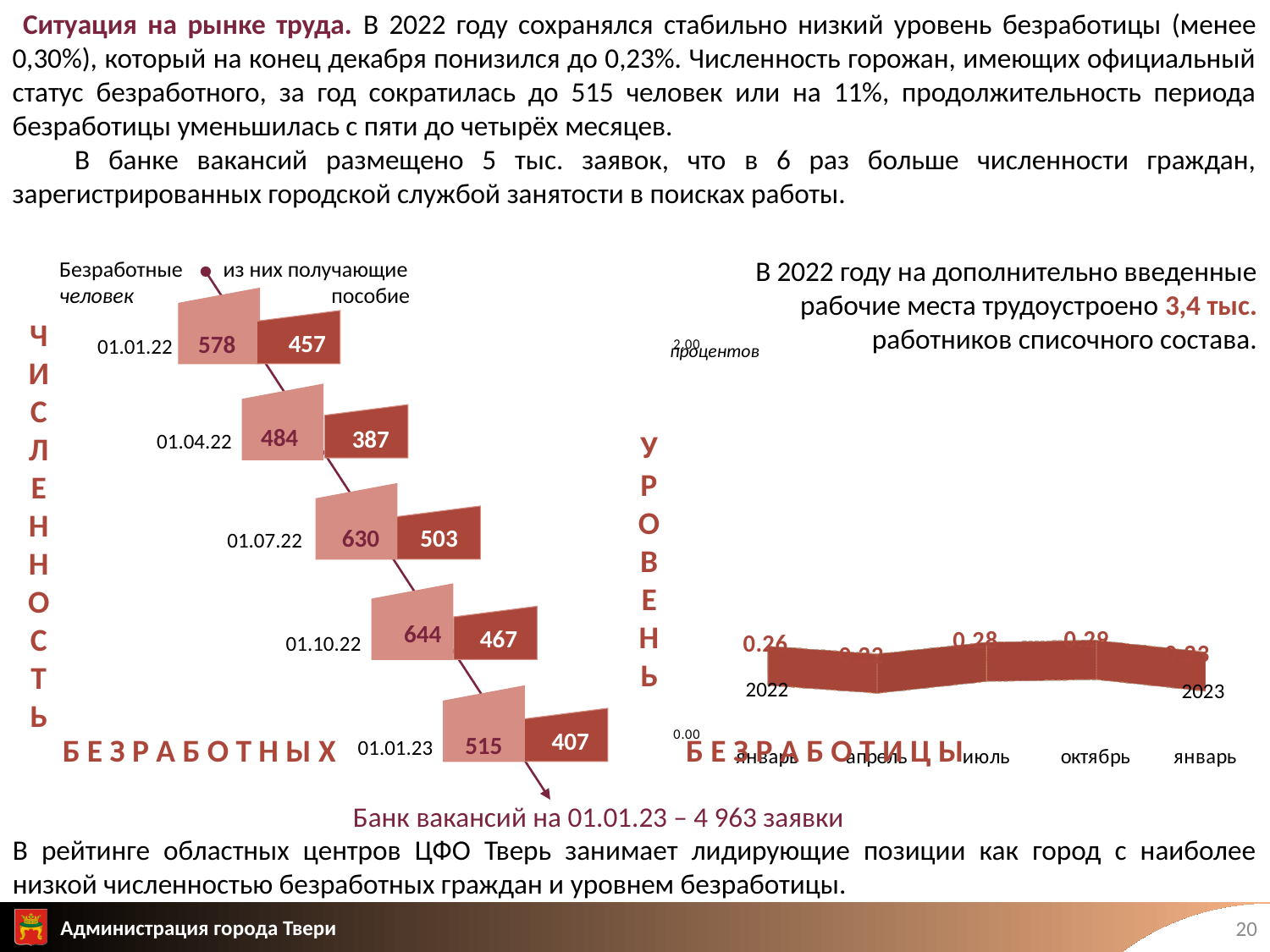
In the left chart (Численность безработных), what is the difference between Безработные and 'из них получающие пособие' on 01.01.22? 121 In the right chart (Уровень безработицы), what is the value for июль? 0.28 In the right chart (Уровень безработицы), what is the highest value shown? 0.29 In the left chart (Численность безработных), which date has more Безработные: 01.07.22 or 01.10.22? 01.10.22 In the left chart (Численность безработных), on which date is the number of Безработные lowest? 01.04.22 In the right chart (Уровень безработицы), what unit is indicated on the axis? процентов In the left chart (Численность безработных), what is the value for 'из них получающие пособие' on 01.01.23? 407 In the left chart (Численность безработных), how many dates are shown? 5 In the left chart (Численность безработных), on which date is the number of Безработные highest? 01.10.22 In the left chart (Численность безработных), what is the value for Безработные on 01.07.22? 630 In the left chart (Численность безработных), how many series does the legend list? 2 What kind of chart is the left chart (Численность безработных)? bar chart